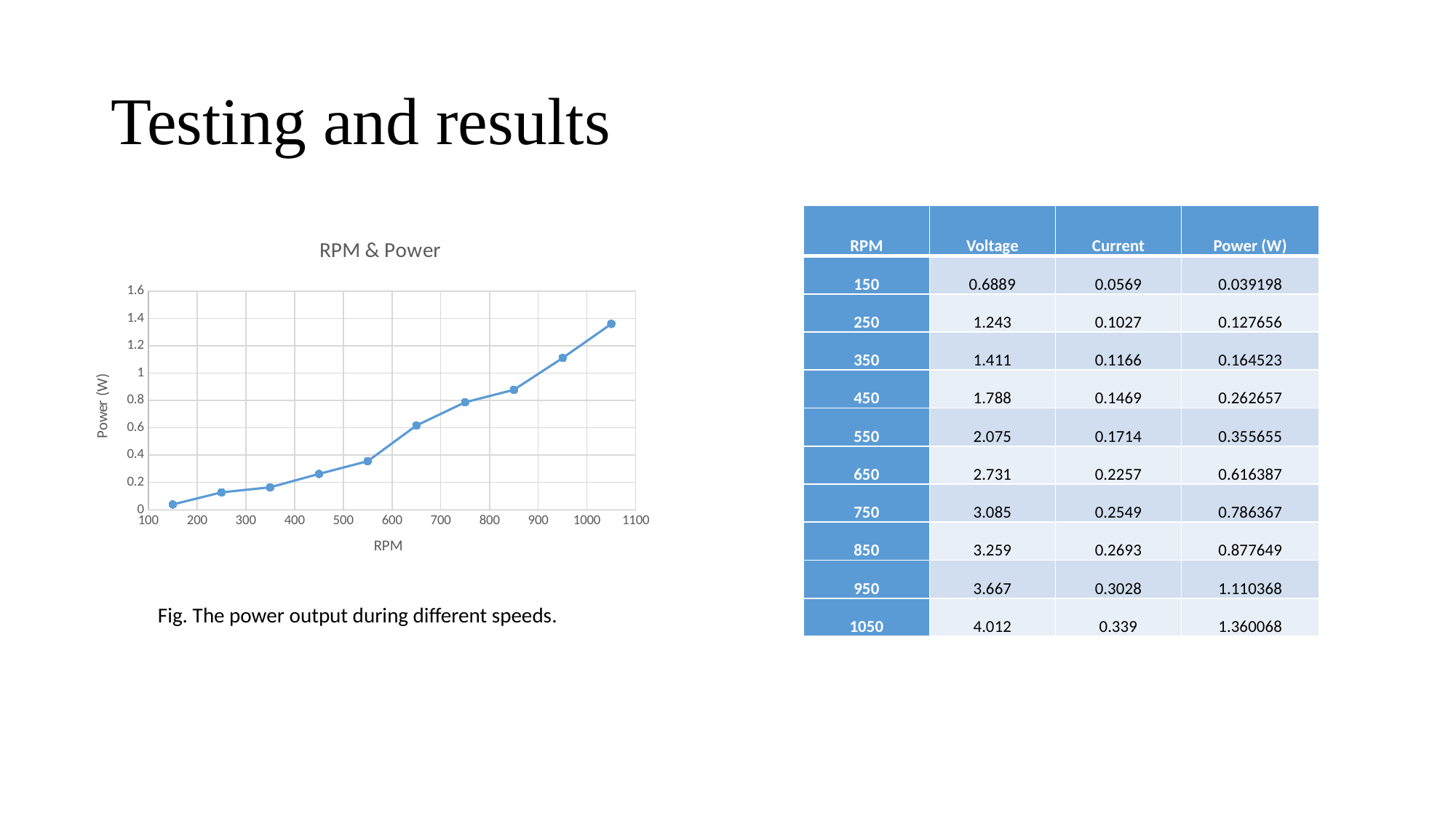
What kind of chart is the 'RPM & Power' chart? line chart Is the power at 850 RPM greater or less than 0.8 W? greater Do the values on the 'RPM & Power' chart rise or fall as RPM increases? rise At which RPM is the power highest on the 'RPM & Power' chart? 1050 How many data points are plotted on the 'RPM & Power' chart? 10 Is the power at 550 RPM greater or less than 0.4 W? less Is the power at 1050 RPM greater or less than 1.4 W? less At which RPM is the power lowest on the 'RPM & Power' chart? 150 Which has the higher power on the 'RPM & Power' chart, 750 RPM or 950 RPM? 950 RPM What is the label of the y axis on the 'RPM & Power' chart? Power (W) What is the title of the chart on the slide? RPM & Power